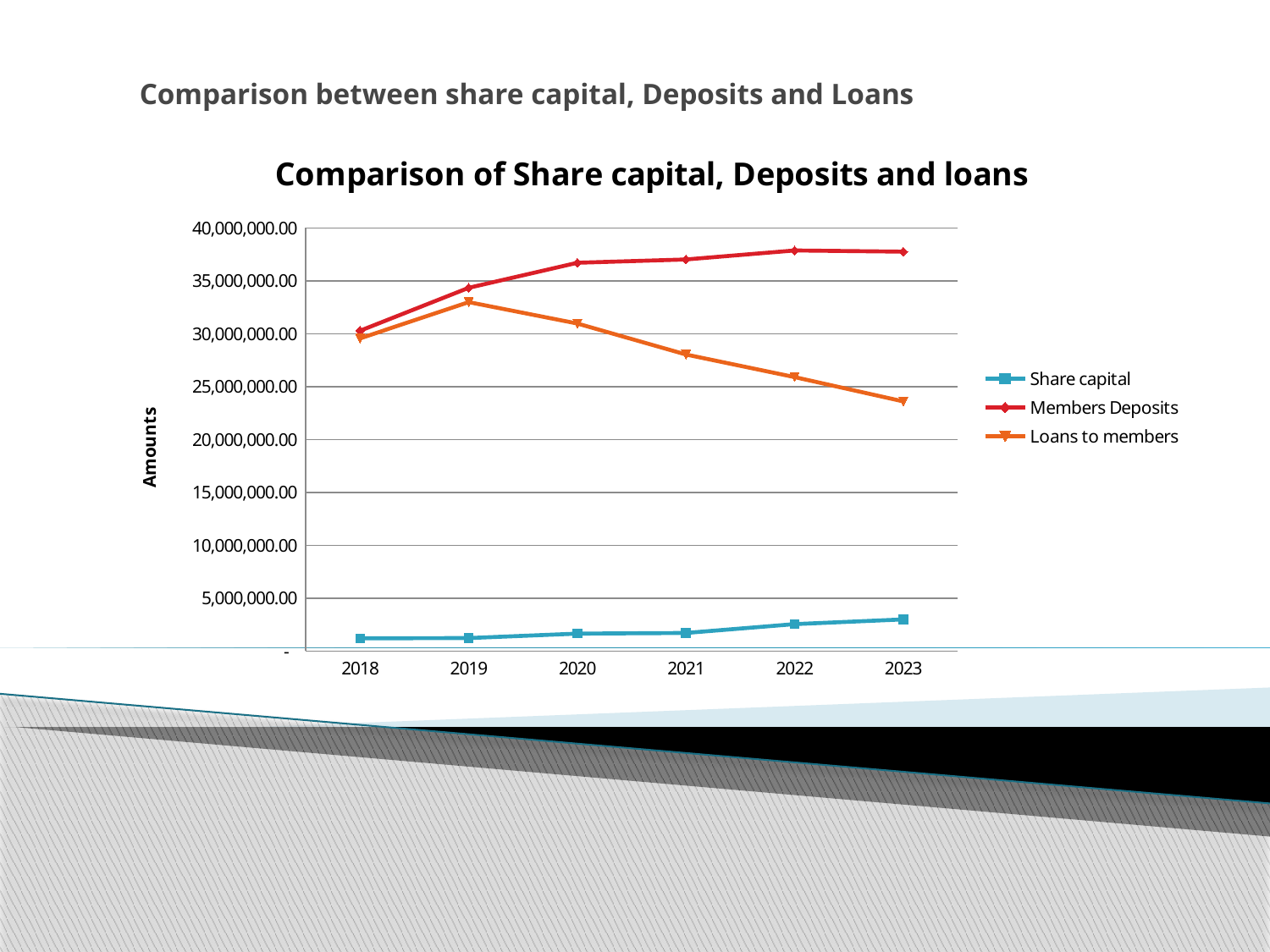
Which series is shown in orange in the legend? Loans to members In 2023, which is larger: Members Deposits or Loans to members? Members Deposits Is the value for Share capital in 2023 greater or less than 5,000,000.00? less In which year is Loans to members at its highest? 2019 What kind of chart is shown on the slide? Line chart Is the value for Members Deposits in 2023 greater or less than 35,000,000.00? greater Does the Loans to members series rise or fall from 2019 to 2023? Fall What is the title of the chart? Comparison of Share capital, Deposits and loans How many years are plotted along the x axis? 6 Does the Share capital series rise or fall from 2018 to 2023? Rise Is the value for Loans to members in 2023 greater or less than 25,000,000.00? less How many series does the legend list? 3